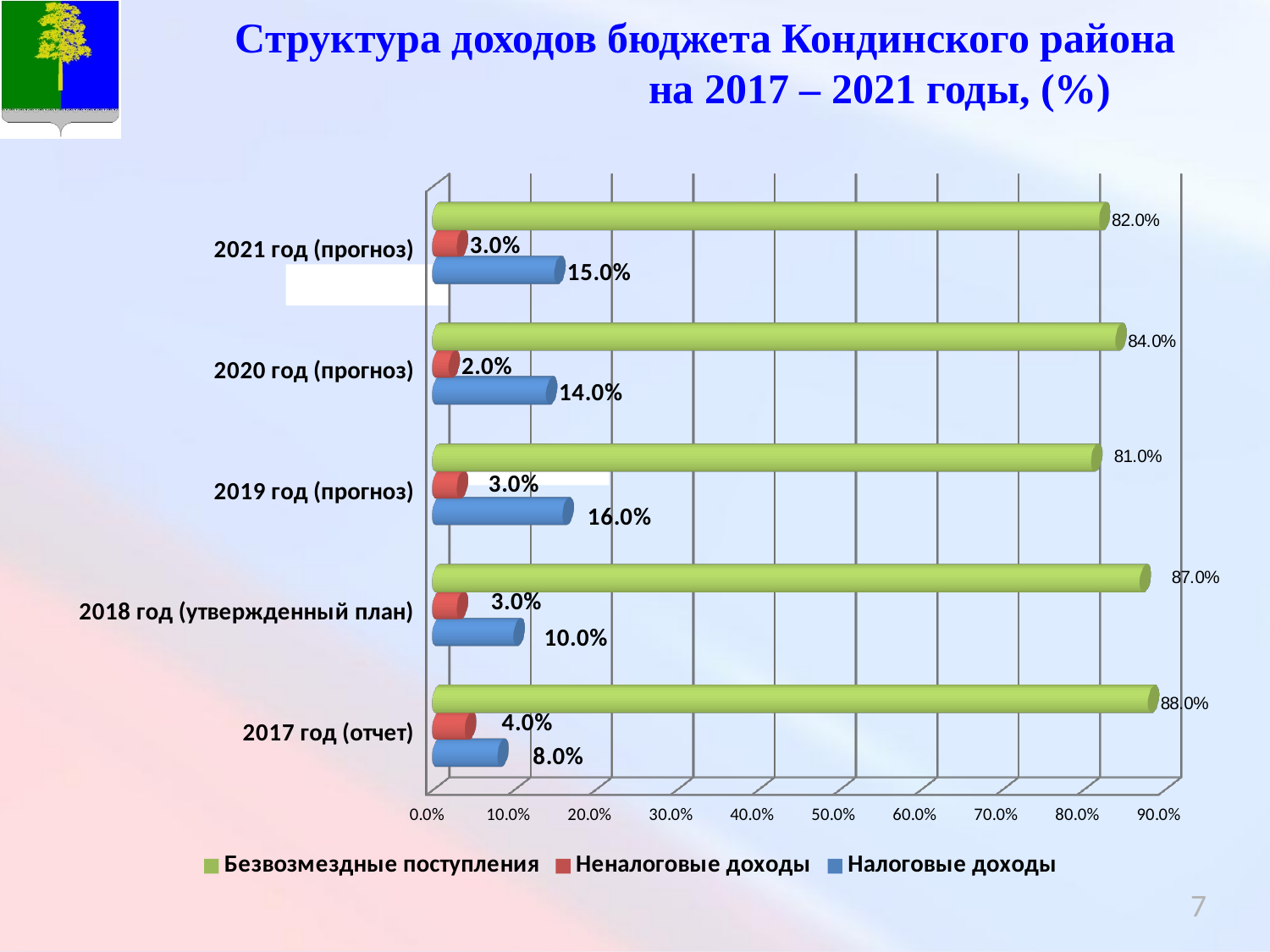
How many year categories are shown on the chart? 5 What is the value of Безвозмездные поступления for 2017 год (отчет)? 88.0% How many series does the legend list? 3 Which year has the highest value for Налоговые доходы? 2019 год (прогноз) What is the value of Неналоговые доходы for 2020 год (прогноз)? 2.0% Which colour represents Неналоговые доходы in the legend? Red What is the value of Налоговые доходы for 2019 год (прогноз)? 16.0% Which is larger: Налоговые доходы in 2018 год (утвержденный план) or in 2020 год (прогноз)? 2020 год (прогноз) What kind of chart is shown on the slide? Bar chart What is the difference between Безвозмездные поступления in 2017 год (отчет) and 2021 год (прогноз)? 6.0% Which year has the lowest value for Безвозмездные поступления? 2019 год (прогноз) What is the total of the three series for 2021 год (прогноз)? 100.0%